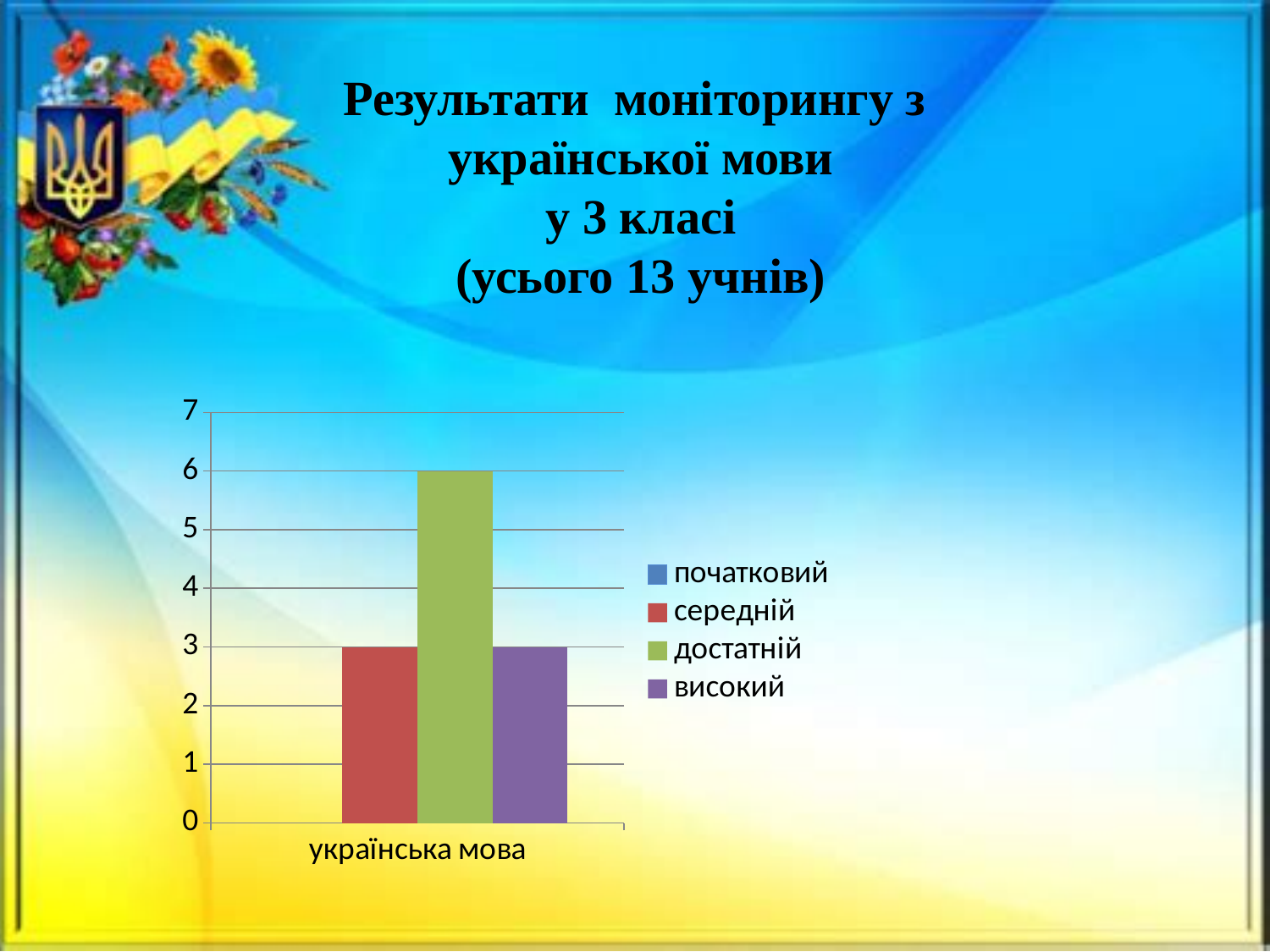
Which is larger, the value for достатній or the value for високий? достатній Which series has the highest value? достатній What is the value for високий? 3 What is the value for середній? 3 What is the label of the category on the x axis? українська мова How many categories are shown on the x axis? 1 What is the difference between the values for достатній and середній? 3 Is the value for середній greater or less than 4? less How many series does the legend list? 4 What kind of chart is shown on the slide? bar chart What is the value for достатній? 6 Is the value for достатній greater or less than 5? greater